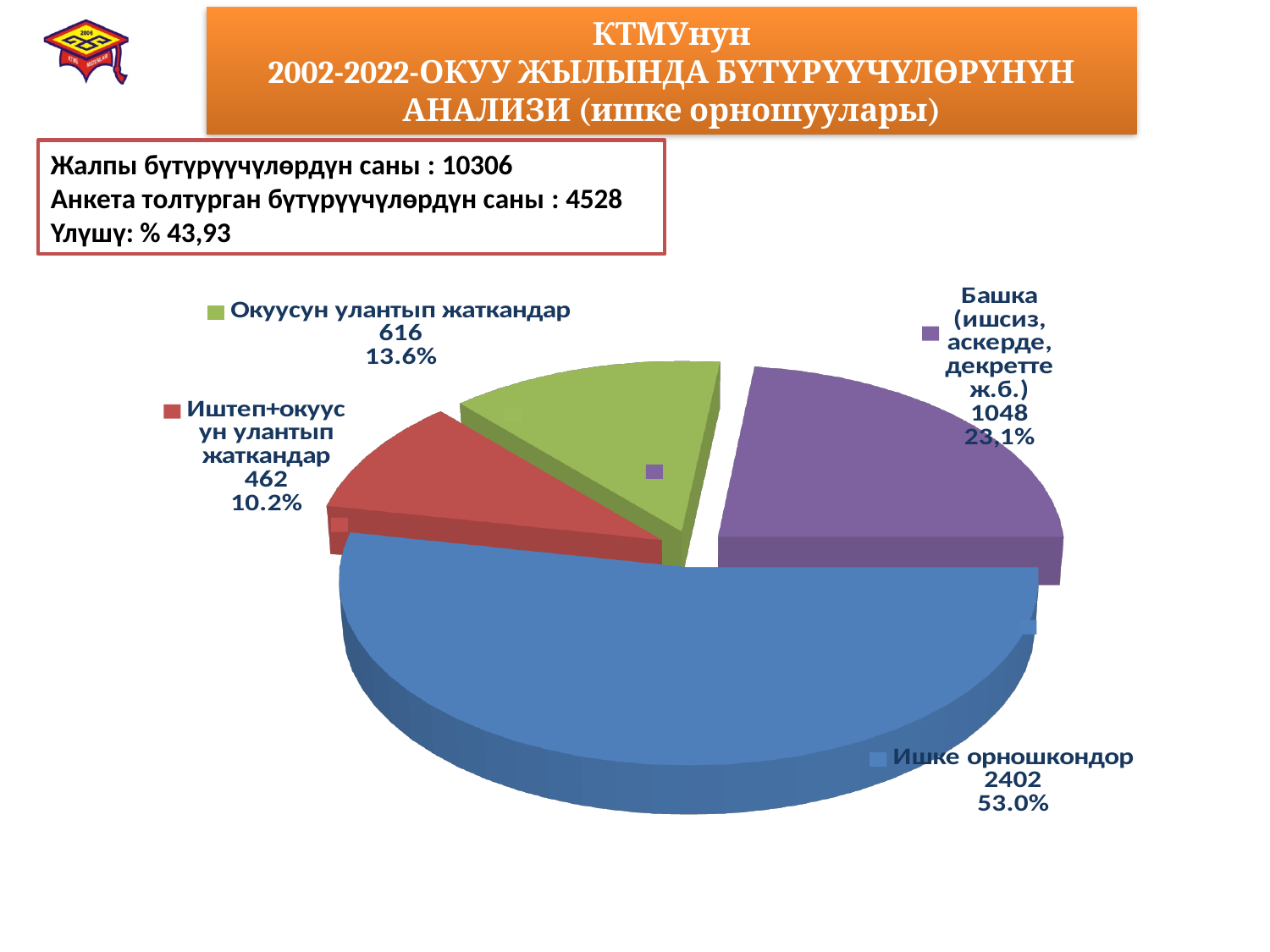
Which is larger, the value for Окуусун улантып жаткандар or the value for Иштеп+окуусун улантып жаткандар? Окуусун улантып жаткандар What percentage share does the Ишке орношкондор slice have? 53.0% How many slices does the pie chart have? 4 What is the value for Иштеп+окуусун улантып жаткандар? 462 Which category has the largest slice? Ишке орношкондор What percentage share does the Башка (ишсиз, аскерде, декретте ж.б.) slice have? 23.1% What is the value for Окуусун улантып жаткандар? 616 What is the difference between the values for Ишке орношкондор and Башка (ишсиз, аскерде, декретте ж.б.)? 1354 What colour is the Ишке орношкондор slice? Blue What kind of chart is shown on the slide? Pie chart Which category has the smallest slice? Иштеп+окуусун улантып жаткандар What is the value for Ишке орношкондор? 2402